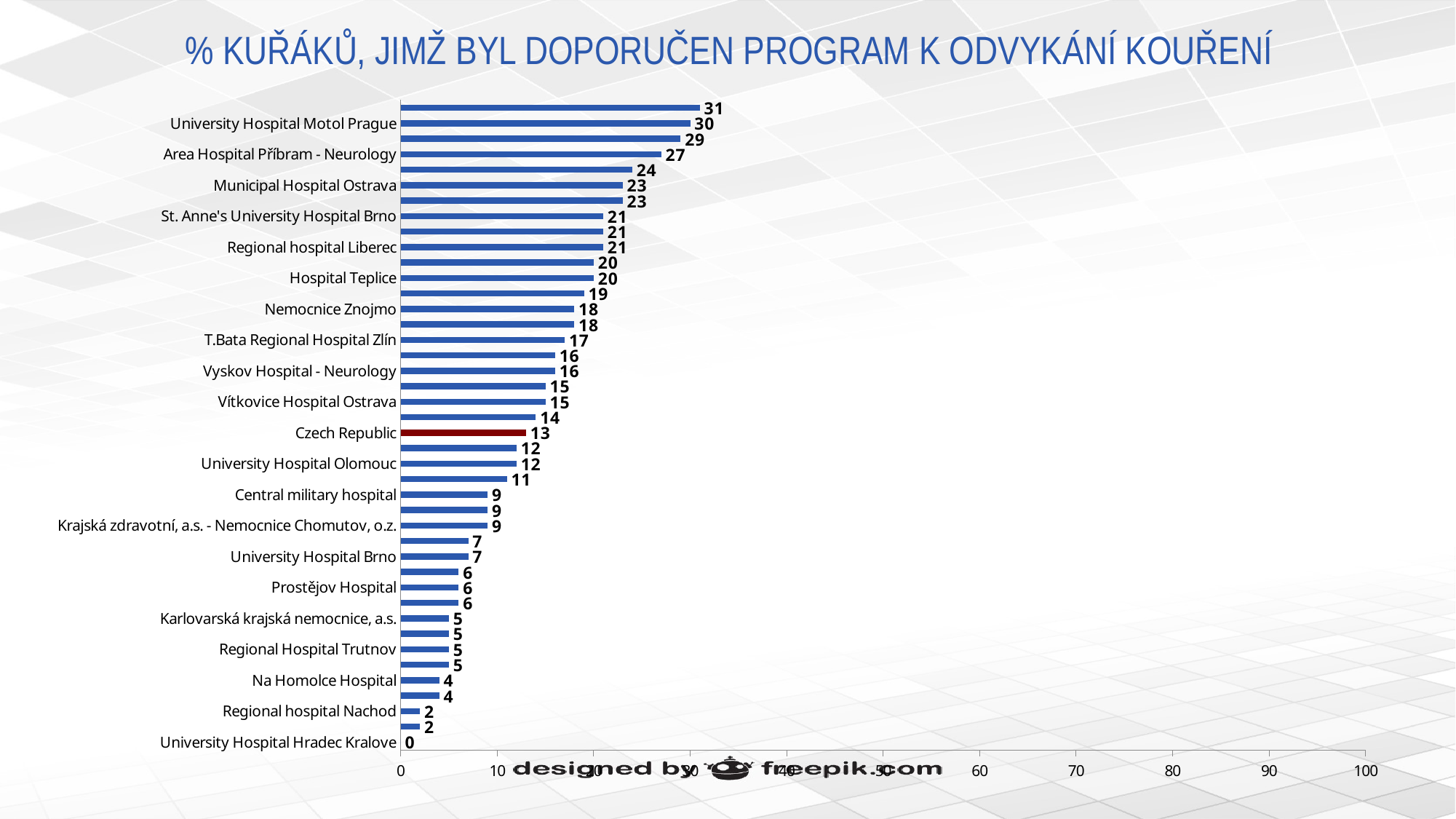
Which has a larger value, Nemocnice Znojmo or University Hospital Olomouc? Nemocnice Znojmo What is the value for University Hospital Motol Prague? 30 What kind of chart is shown on the slide? Bar chart Do the bar values increase or decrease from the top of the chart to the bottom? Decrease What is the value for Czech Republic? 13 What is the value for University Hospital Hradec Kralove? 0 Which labeled hospital has the lowest value? University Hospital Hradec Kralove Which category's bar is coloured dark red instead of blue? Czech Republic What is the difference between the values for Area Hospital Příbram - Neurology and Municipal Hospital Ostrava? 4 What is the value for Hospital Teplice? 20 What is the value for T.Bata Regional Hospital Zlín? 17 Is the value for Vyskov Hospital - Neurology greater or less than 20? less